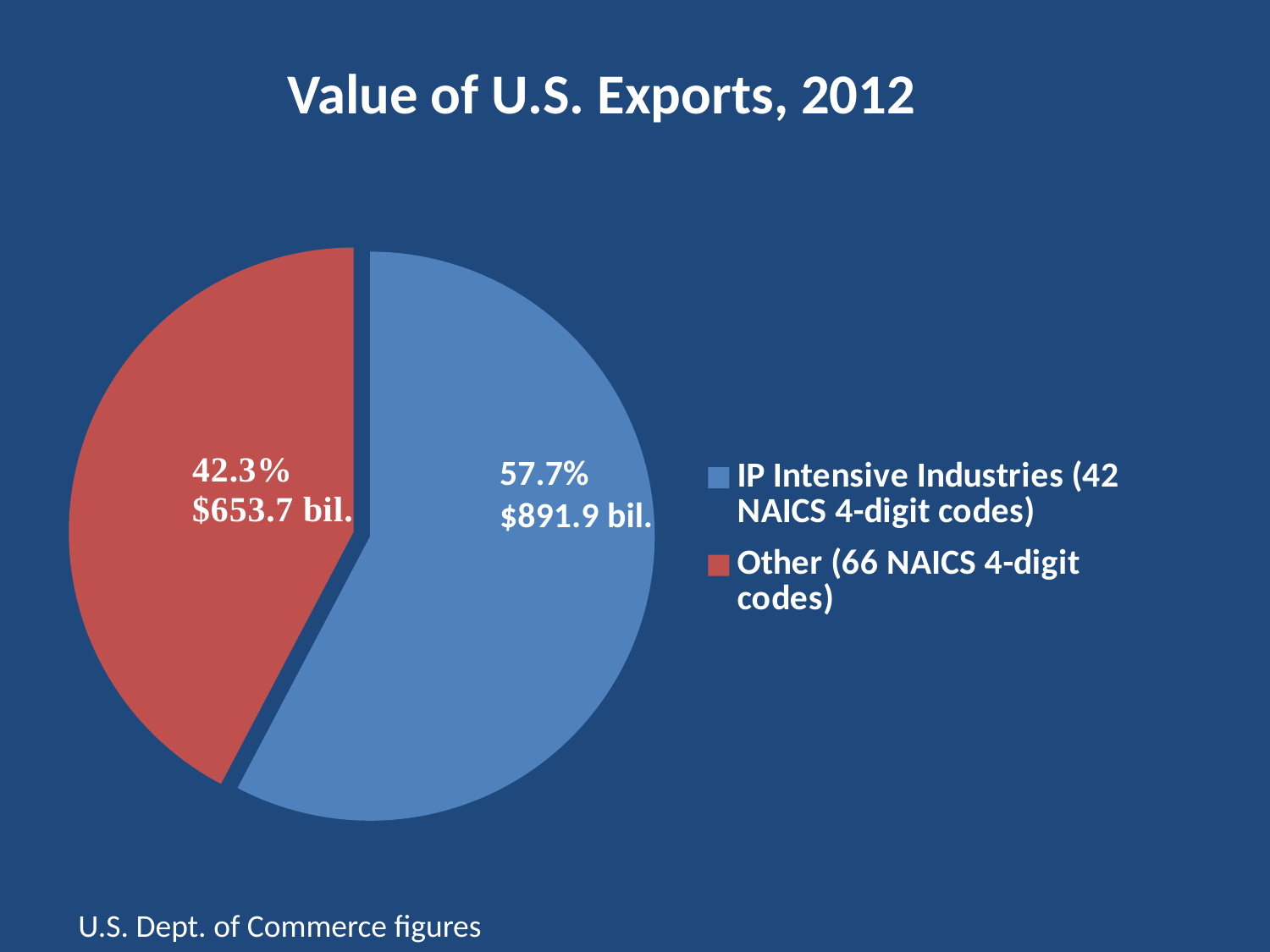
Which category has the largest slice of the pie? IP Intensive Industries (42 NAICS 4-digit codes) Which category has the smallest slice of the pie? Other (66 NAICS 4-digit codes) What is the export value shown for IP Intensive Industries (42 NAICS 4-digit codes)? $891.9 bil. What is the title of the chart? Value of U.S. Exports, 2012 What is the export value shown for Other (66 NAICS 4-digit codes)? $653.7 bil. What kind of chart is shown on the slide? pie chart What share of the pie does Other (66 NAICS 4-digit codes) represent? 42.3% How many categories does the pie chart show? 2 Which is larger, the export value for IP Intensive Industries or for Other? IP Intensive Industries What share of the pie does IP Intensive Industries (42 NAICS 4-digit codes) represent? 57.7% What is the difference in export value between IP Intensive Industries and Other? $238.2 bil. What colour is the slice for Other (66 NAICS 4-digit codes)? red